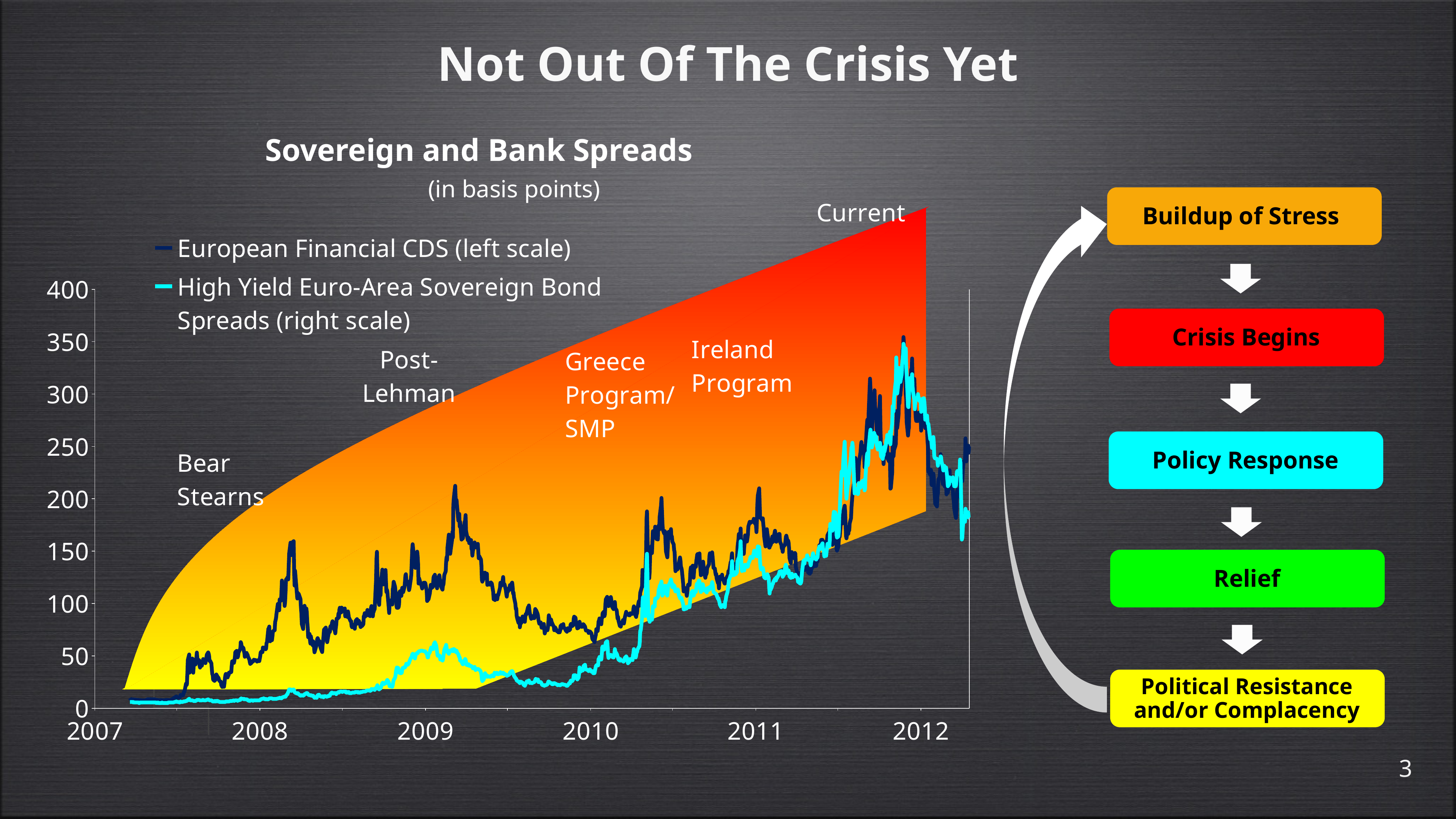
Is the peak value of the European Financial CDS series in late 2011 greater or less than 300 on the left scale? greater How many series does the chart's legend list? 2 What is the highest value shown on the left axis of the chart? 400 How many year labels are shown on the x axis of the chart? 6 What kind of chart is shown on the slide? line chart Is the Post-Lehman peak of the European Financial CDS series in early 2009 greater or less than 250 on the left scale? less Is the Post-Lehman peak of the European Financial CDS series in early 2009 greater or less than 150 on the left scale? greater What is the title of the chart? Sovereign and Bank Spreads Overall, do the spreads in the chart rise or fall from 2007 to 2012? rise In what units are the values in the chart expressed? basis points